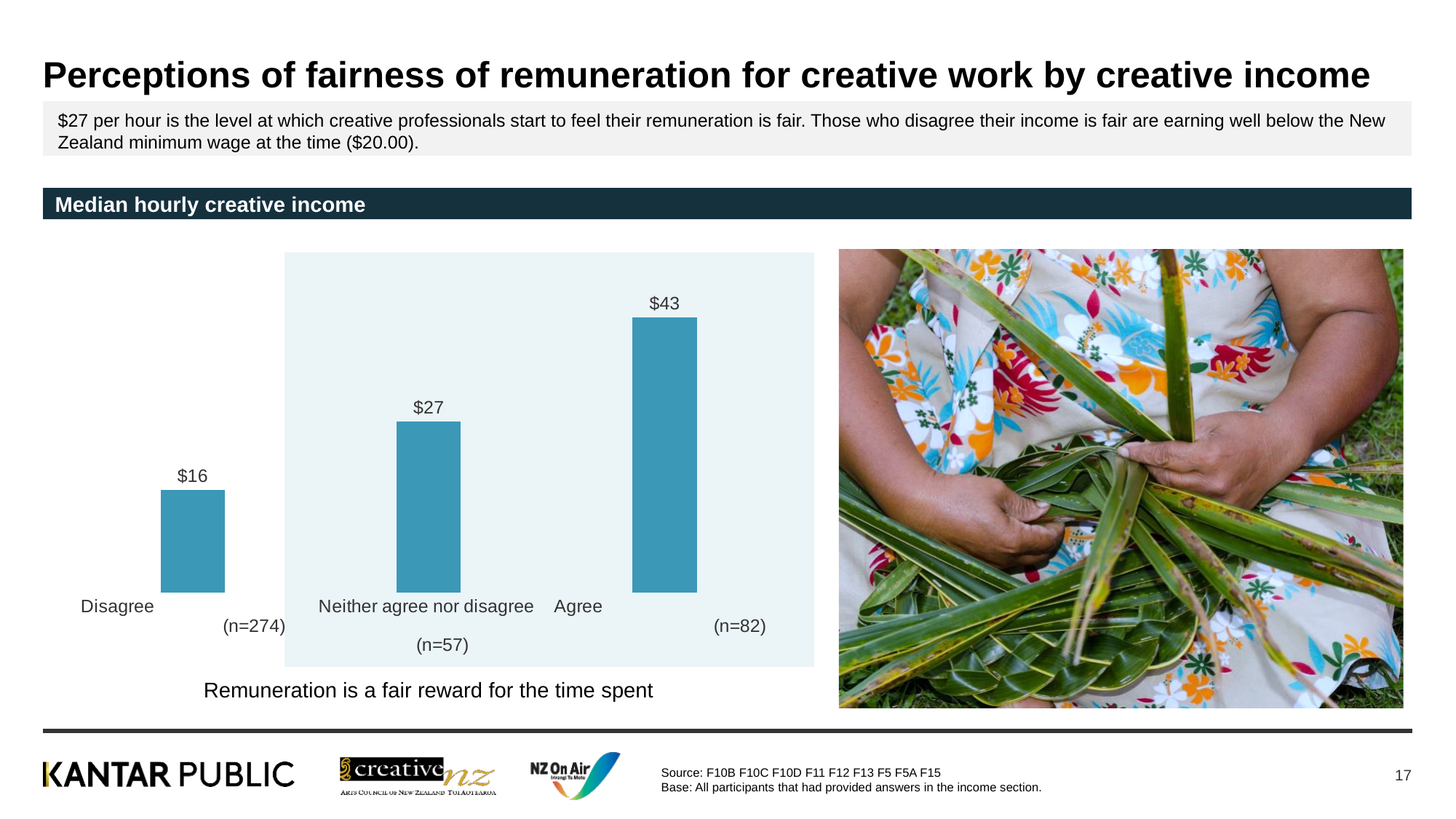
What is the difference in median hourly creative income between the Neither agree nor disagree and Disagree groups? $11 What is the median hourly creative income for those who Agree that remuneration is a fair reward? $43 What is the difference in median hourly creative income between the Agree and Disagree groups? $27 What kind of chart is used to show median hourly creative income? Bar chart Which category has the highest median hourly creative income? Agree What is the median hourly creative income for those who Disagree that remuneration is a fair reward? $16 Do the median hourly creative income values rise or fall from Disagree to Agree? Rise How many categories are shown in the chart? 3 What is the median hourly creative income for those who Neither agree nor disagree? $27 Which has a higher median hourly creative income, the Agree group or the Neither agree nor disagree group? Agree What is the sample size (n) shown for the Disagree category? n=274 Which category has the lowest median hourly creative income? Disagree